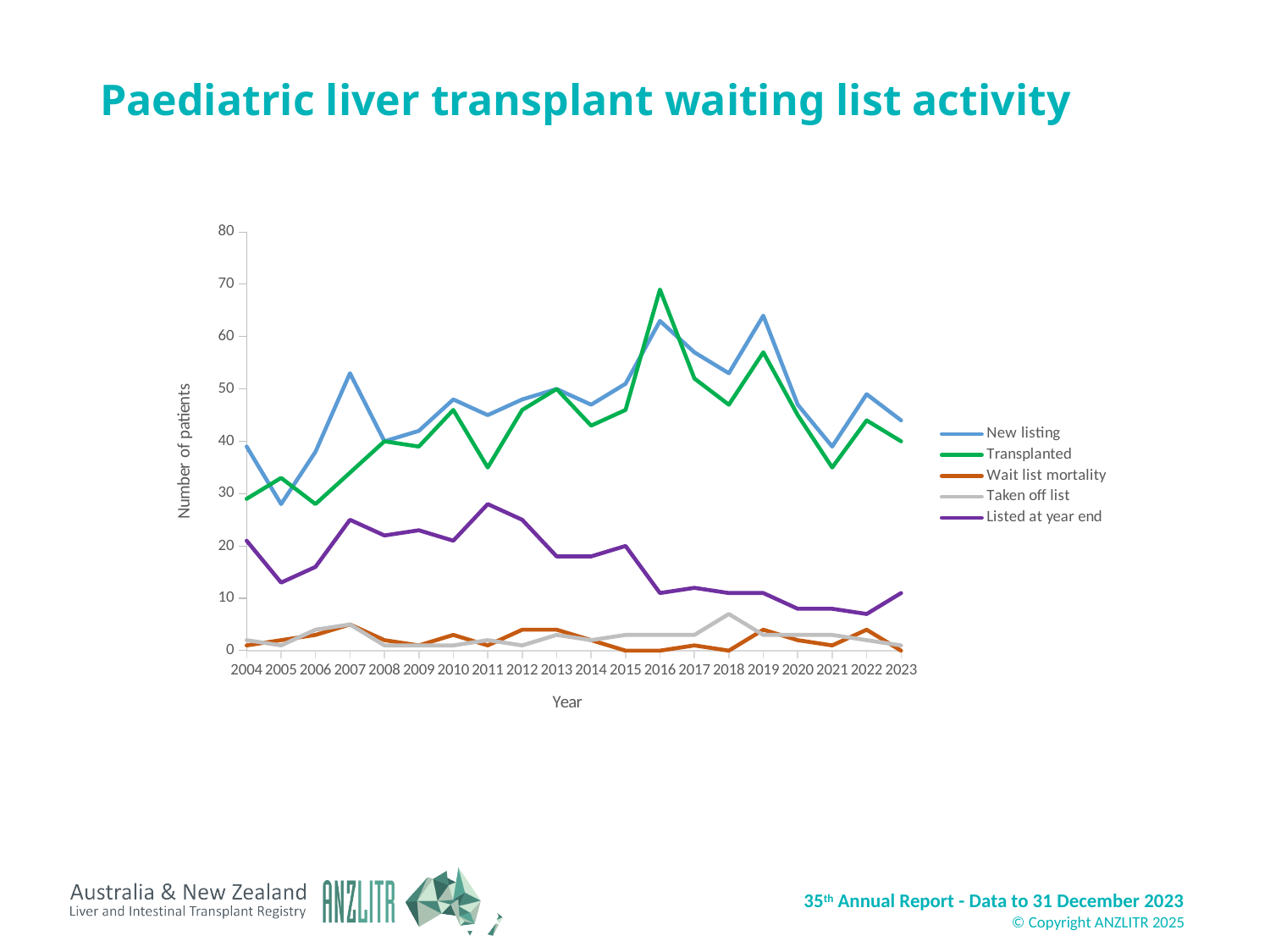
What kind of chart is shown on the slide? Line chart Is the Listed at year end value for 2016 greater or less than 20? less What is the label on the vertical axis? Number of patients In which year does the Transplanted series reach its highest value? 2016 How many series does the legend list? 5 How many years are plotted along the x axis? 20 In 2019, which is higher: New listing or Transplanted? New listing Is the New listing value for 2005 greater or less than 30? less Is the New listing value for 2007 greater or less than 50? greater In 2016, which is higher: New listing or Transplanted? Transplanted Does the Listed at year end series rise or fall between 2011 and 2016? Fall